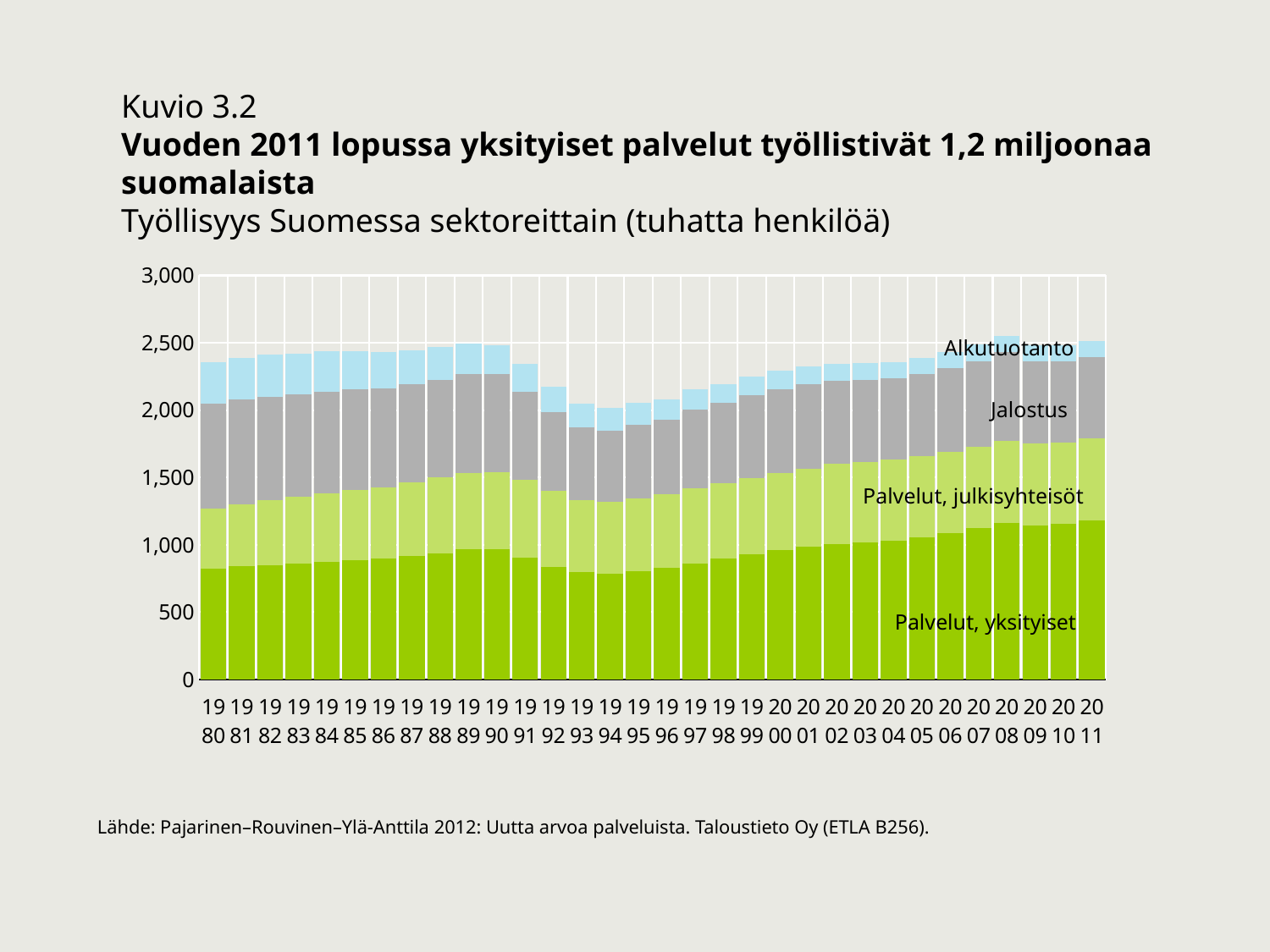
Which sector is the smallest in 2011? Alkutuotanto What kind of chart is shown on the slide? Stacked bar chart How many sectors (series) are stacked in each bar? 4 How many years (bars) are plotted on the x axis? 32 Which sector is the largest in 2011? Palvelut, yksityiset Which is larger, Palvelut, yksityiset in 2011 or Palvelut, yksityiset in 1980? 2011 Which sector forms the bottom (green) segment of each bar? Palvelut, yksityiset Does the value for Palvelut, yksityiset rise or fall from 1994 to 2011? rise Is the value for Palvelut, yksityiset in 2011 greater or less than 1,000? greater Is the value for Palvelut, yksityiset in 1980 greater or less than 1,000? less Is the total employment (full stacked bar) in 1980 greater or less than 2,000? greater Which year has the lowest total employment (shortest stacked bar)? 1994